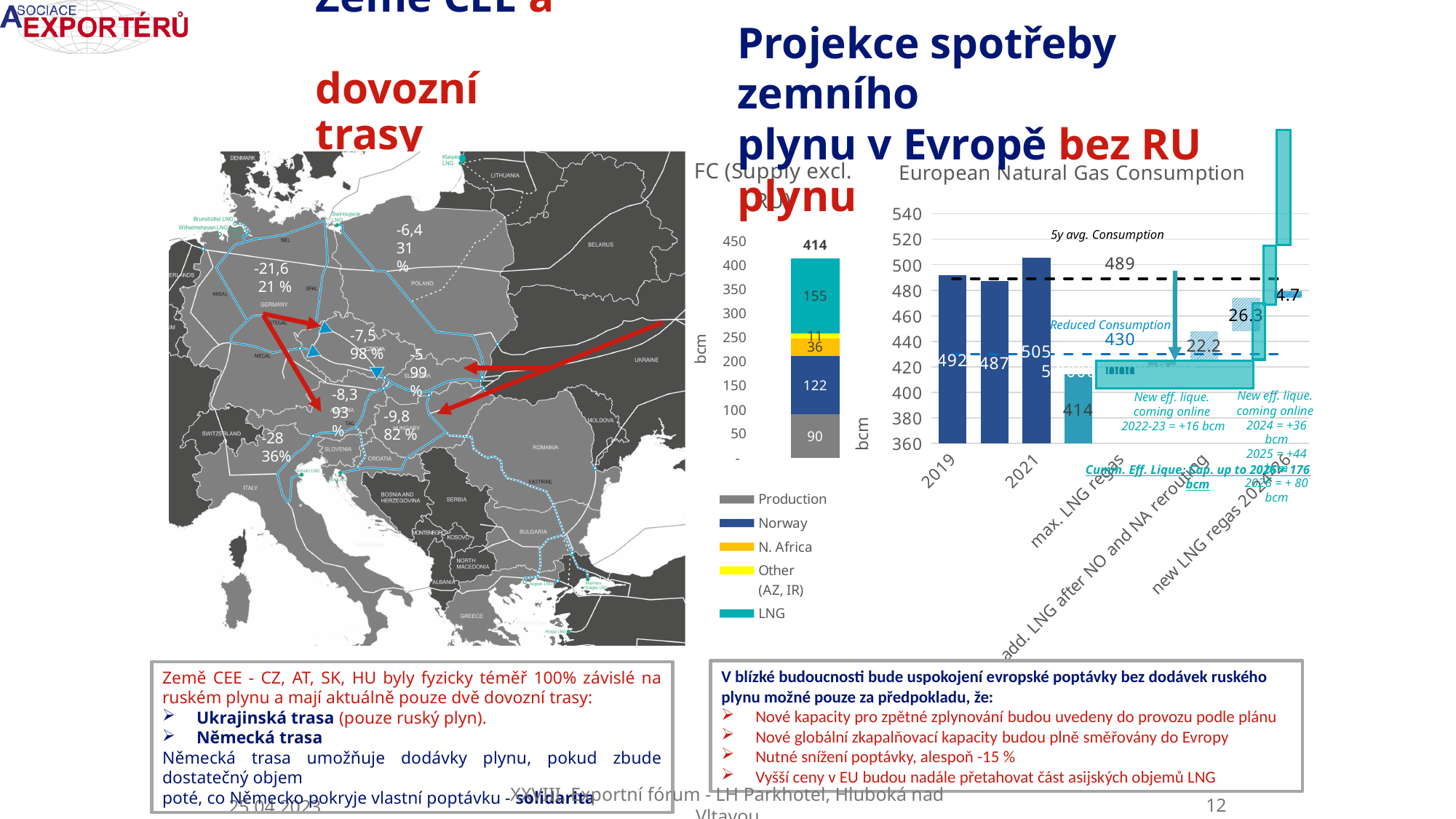
In the 'European Natural Gas Consumption' chart, what value is shown for the 5y avg. Consumption line? 489 In the 'FC (Supply excl. RU)' chart, which segment is the largest? LNG In the 'European Natural Gas Consumption' chart, what is the value for 2021? 505 In the 'FC (Supply excl. RU)' chart, what is the value of the Norway segment? 122 In the 'FC (Supply excl. RU)' chart, what is the value of the LNG segment? 155 In the 'FC (Supply excl. RU)' chart, how many series does the legend list? 5 In the 'FC (Supply excl. RU)' chart, what is the value of the Production segment? 90 In the 'European Natural Gas Consumption' chart, which is larger, the value for 2019 or 2021? 2021 In the 'FC (Supply excl. RU)' chart, what is the total of the stacked bar? 414 In the 'European Natural Gas Consumption' chart, what is the value for 2019? 492 In the 'FC (Supply excl. RU)' chart, what is the difference between the Norway and N. Africa segments? 86 In the 'FC (Supply excl. RU)' chart, which segment is the smallest? Other (AZ, IR)